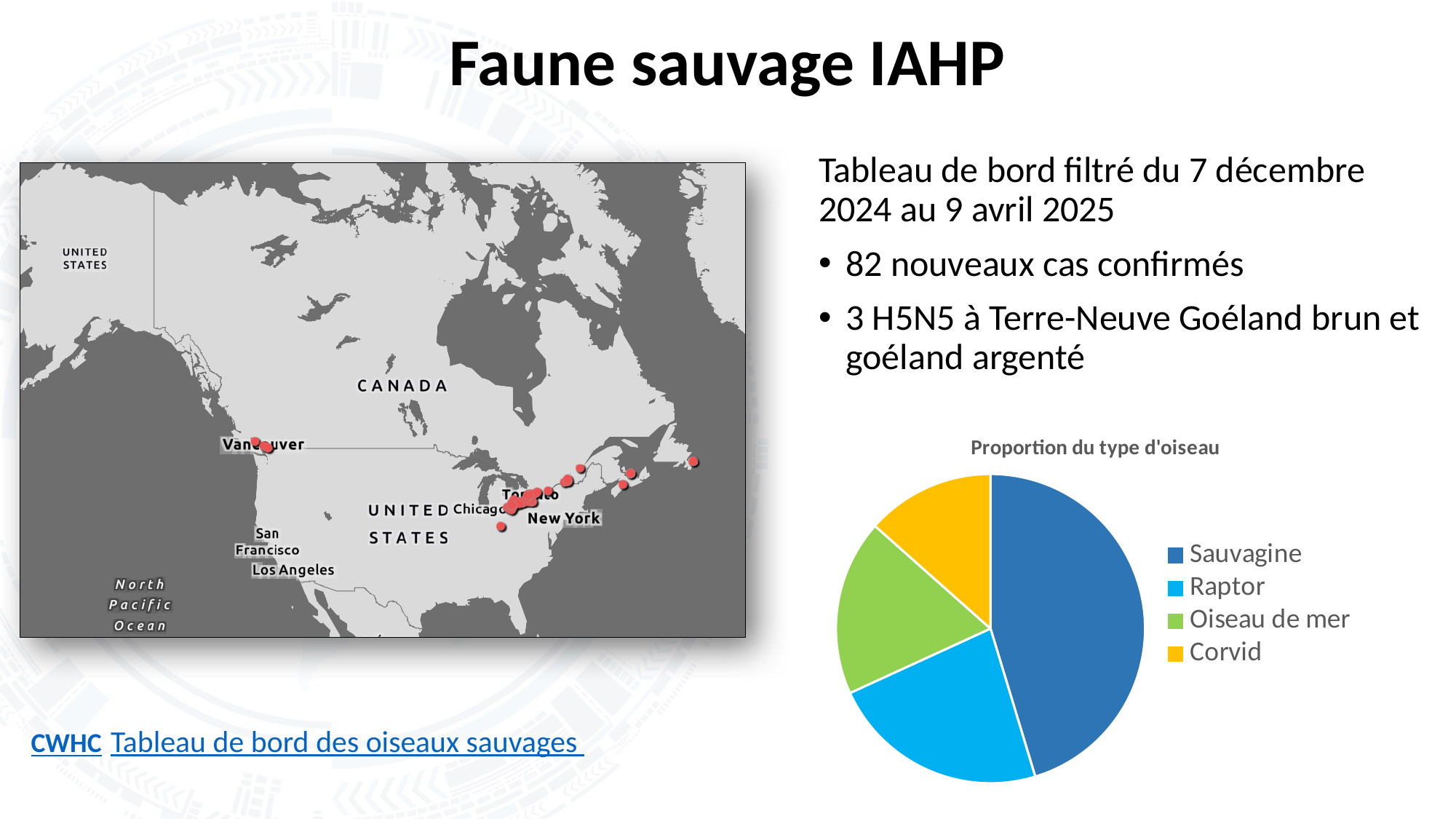
In the pie chart "Proportion du type d'oiseau", which slice is larger: Sauvagine or Raptor? Sauvagine Does the Sauvagine slice in the pie chart "Proportion du type d'oiseau" take up more or less than half of the pie? less How many entries does the legend of the pie chart "Proportion du type d'oiseau" list? 4 In the pie chart "Proportion du type d'oiseau", which slice is larger: Sauvagine or Corvid? Sauvagine In the pie chart "Proportion du type d'oiseau", which slice is larger: Sauvagine or Oiseau de mer? Sauvagine What is the title of the pie chart on the slide? Proportion du type d'oiseau What colour is the Corvid slice in the pie chart "Proportion du type d'oiseau"? Yellow Which bird type has the largest slice in the pie chart "Proportion du type d'oiseau"? Sauvagine How many bird types (slices) does the pie chart "Proportion du type d'oiseau" show? 4 What kind of chart is shown under the title "Proportion du type d'oiseau"? Pie chart